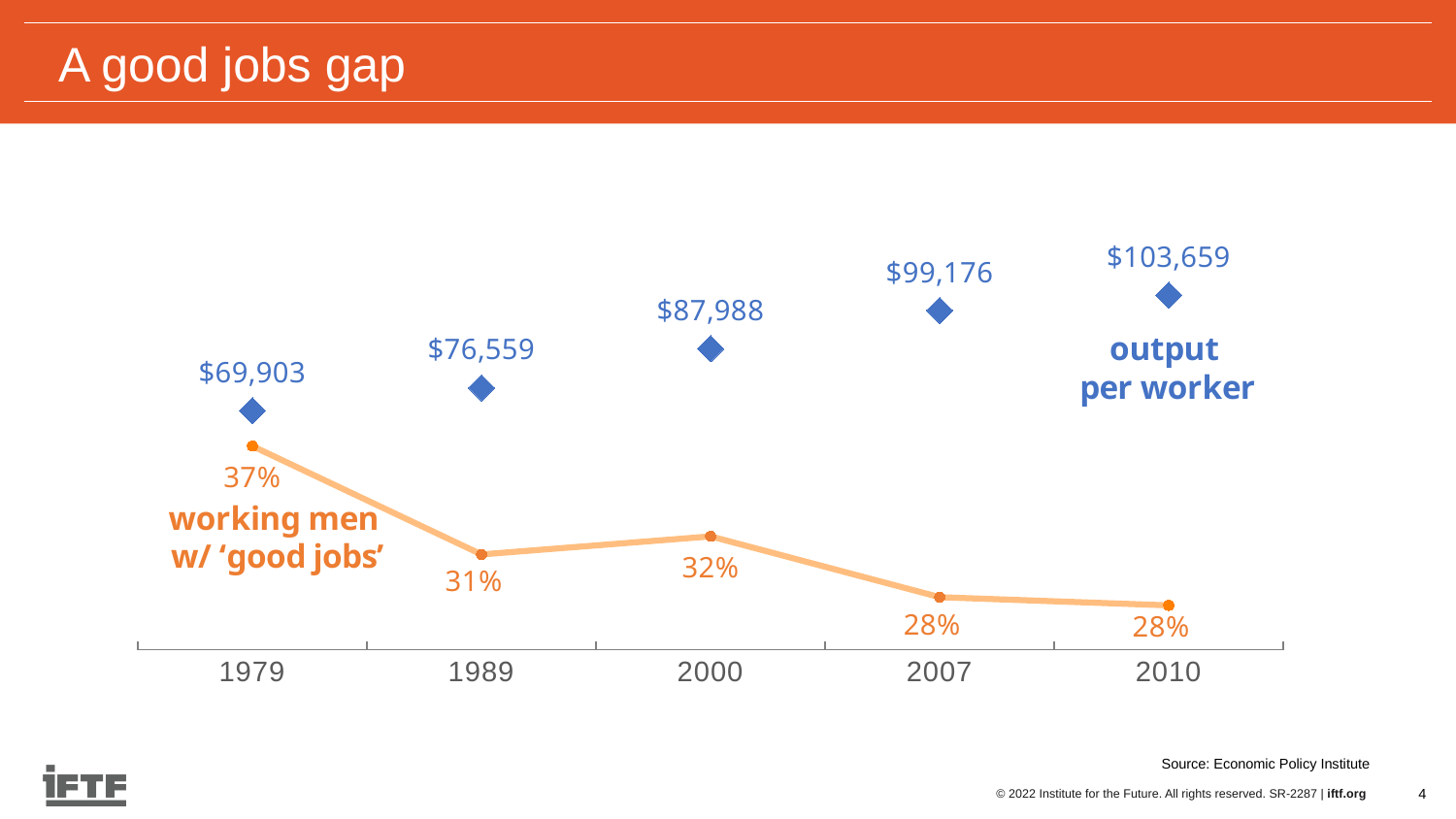
How many years are shown on the x axis? 5 What is the output per worker value shown for 2000? $87,988 Does the share of working men with 'good jobs' rise or fall from 1979 to 2010? fall What is the output per worker value shown for 1979? $69,903 What percentage of working men had 'good jobs' in 1989? 31% In which year is output per worker highest? 2010 How many data series are plotted on the chart? 2 What is the difference in output per worker between 2010 and 1979? $33,756 What is the title of the slide containing the chart? A good jobs gap In which year is the share of working men with 'good jobs' highest? 1979 Which is larger, output per worker in 2007 or in 1989? 2007 By how many percentage points did the share of working men with 'good jobs' fall from 1979 to 2010? 9 percentage points